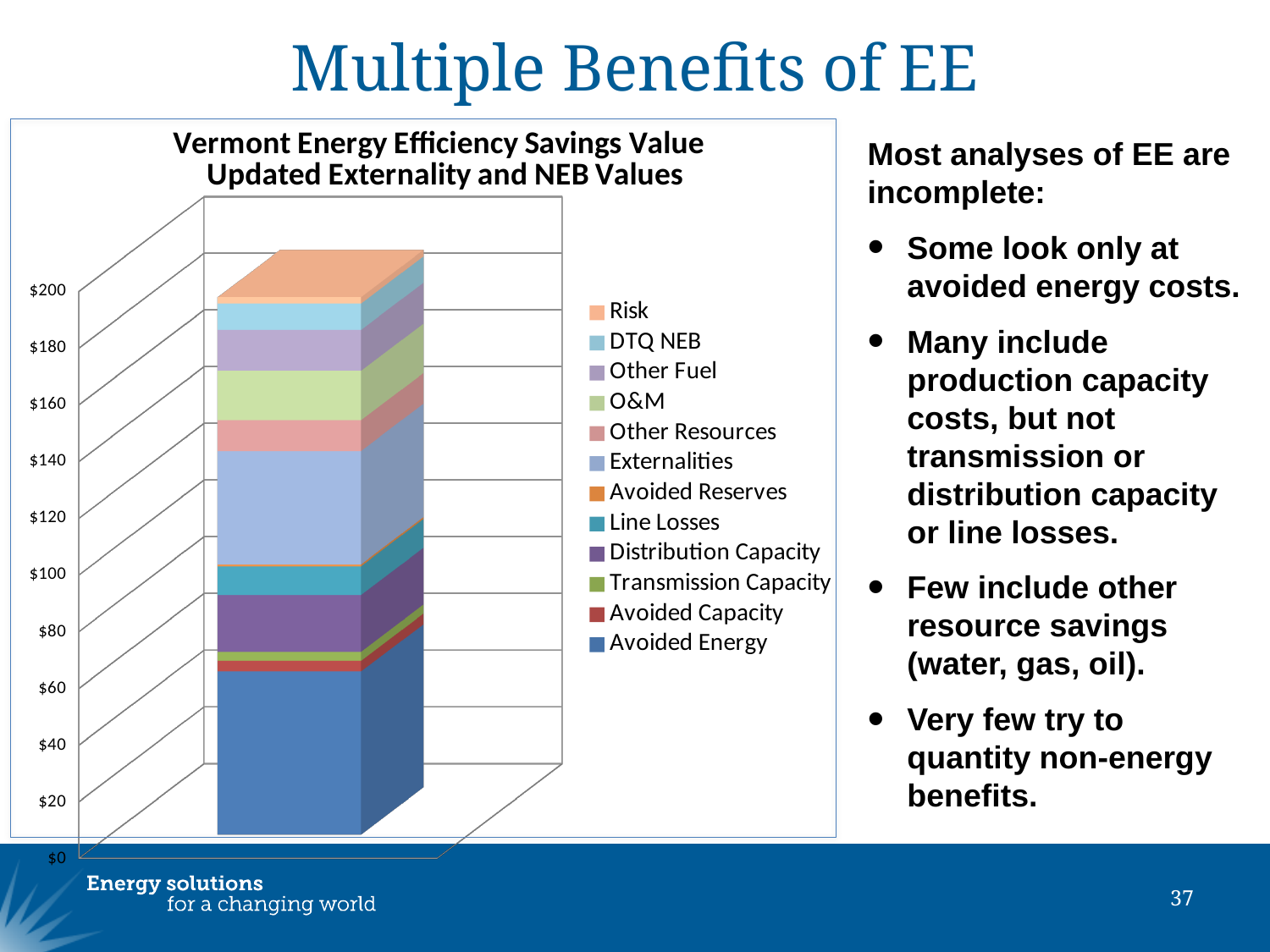
Which series is listed first in the chart's legend? Risk How many series does the chart's legend list? 12 Which segment is larger in the stacked bar, Externalities or O&M? Externalities How many bars are plotted in the chart? 1 Which segment is larger in the stacked bar, Avoided Energy or Risk? Avoided Energy Which segment is larger in the stacked bar, Avoided Energy or Externalities? Avoided Energy Which series forms the largest segment of the stacked bar? Avoided Energy Is the value of the Avoided Energy segment greater or less than $40? greater Is the value of the Avoided Energy segment greater or less than $100? less What is the title of the chart? Vermont Energy Efficiency Savings Value Updated Externality and NEB Values What kind of chart is shown on the slide? Stacked bar chart